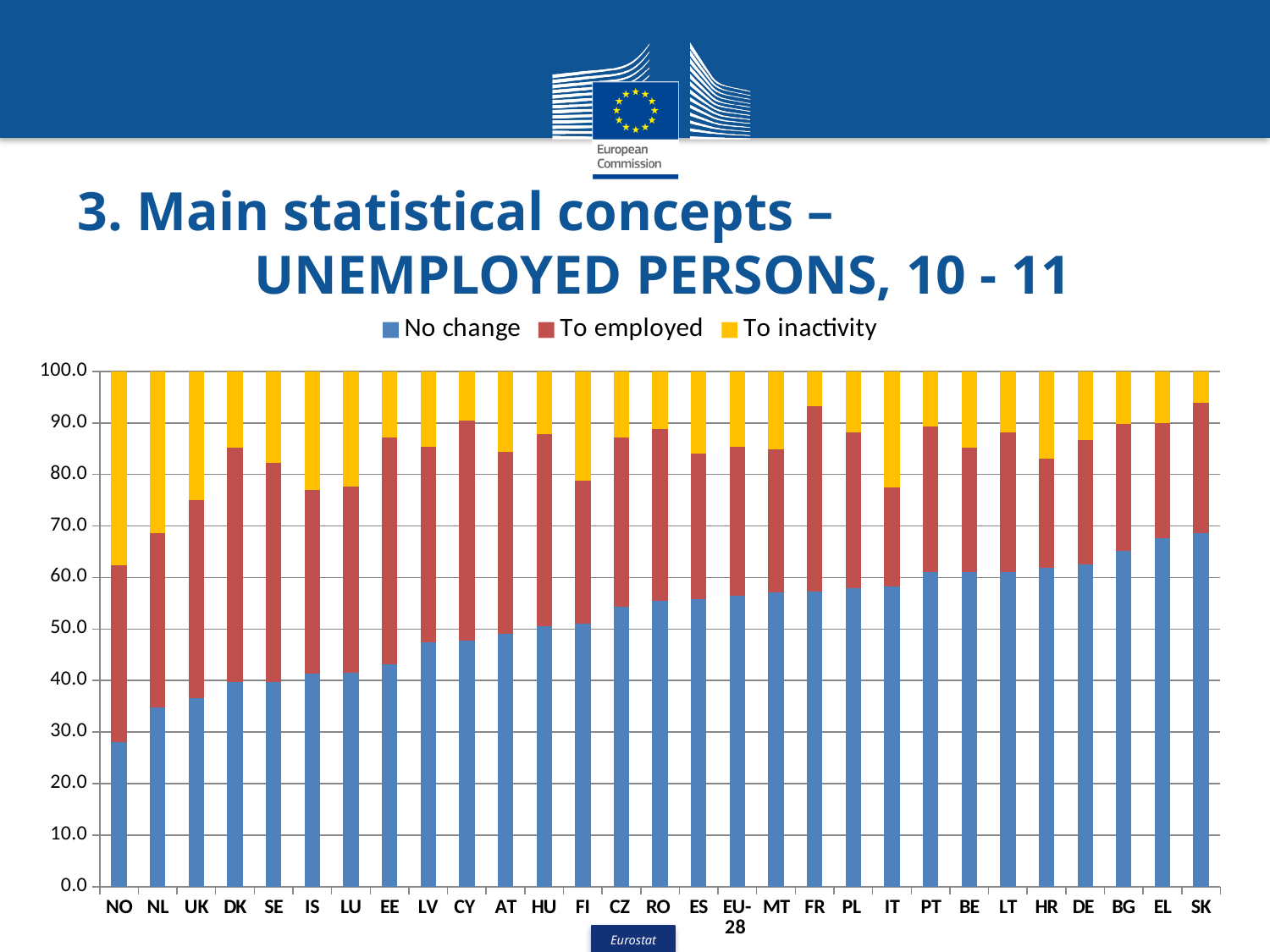
Is the 'No change' value for SK greater or less than 70.0? less Which category has the lowest value for 'No change'? NO Which has the larger 'No change' value, NO or SK? SK What is the total of the stacked bar for NO? 100.0 How many countries/categories are shown on the x axis? 29 Is the 'No change' value for NO greater or less than 30.0? less Which category has the largest 'To inactivity' segment? NO Is the 'No change' value for UK greater or less than 40.0? less How many series does the legend list? 3 Do the 'No change' values rise or fall moving from left to right along the x axis? rise Which series is shown in yellow in the legend? To inactivity What kind of chart is shown on the slide? stacked bar chart